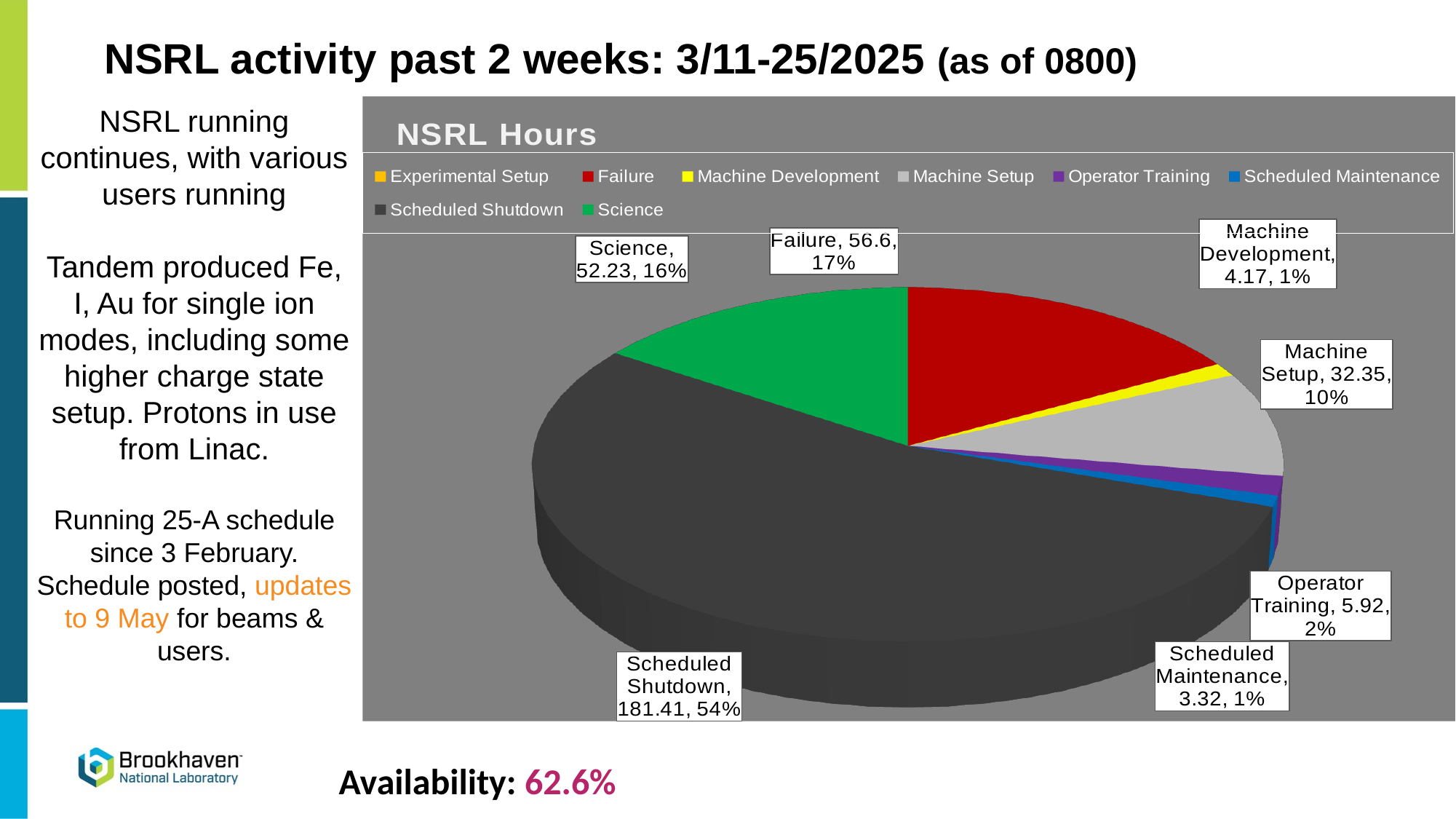
What percentage share of the pie does Scheduled Shutdown have? 54% Which has more hours, Machine Setup or Operator Training? Machine Setup Which category has the largest slice of the pie? Scheduled Shutdown What is the difference in hours between Failure and Science? 4.37 How many hours are labelled for Failure? 56.6 Of the slices with data labels, which category has the fewest hours? Scheduled Maintenance How many hours are labelled for Machine Setup? 32.35 How many hours are labelled for Scheduled Shutdown? 181.41 What is the title of the chart? NSRL Hours What kind of chart is shown on the slide? Pie chart How many categories does the legend list? 8 What percentage share of the pie does Science have? 16%